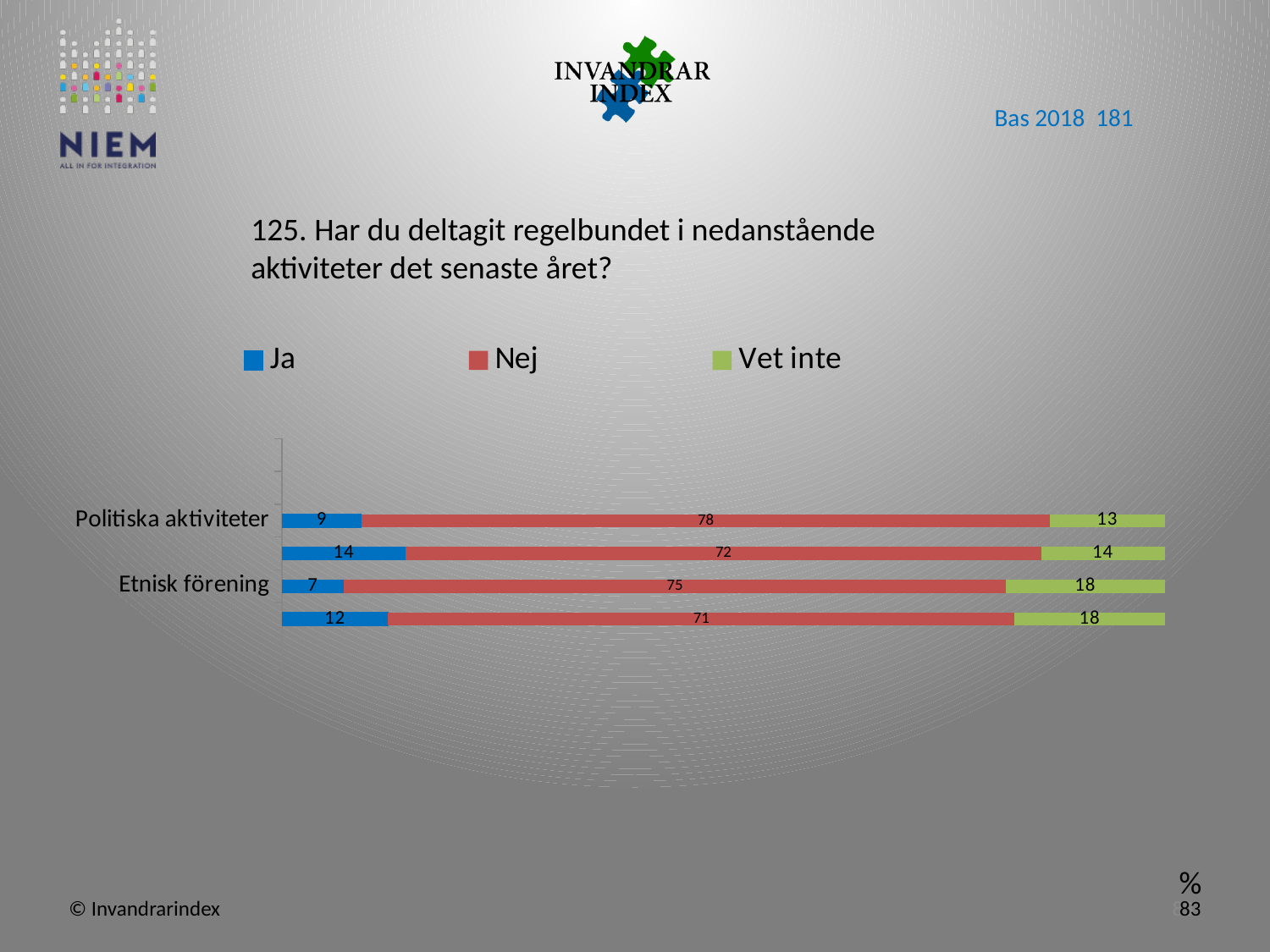
Which has the larger Ja value, Politiska aktiviteter or Etnisk förening? Politiska aktiviteter What is the difference between the Nej values for Politiska aktiviteter and Etnisk förening? 3 What is the value for Vet inte for Etnisk förening? 18 What is the value for Nej for Politiska aktiviteter? 78 What is the value for Ja for Politiska aktiviteter? 9 Which series has the highest value for Etnisk förening? Nej What are the legend entries of the chart? Ja, Nej, Vet inte What kind of chart is shown on the slide? Stacked bar chart How many series does the legend list? 3 What is the value for Ja for Etnisk förening? 7 What is the total of the stacked bar for Politiska aktiviteter? 100 What is the value for Nej for Etnisk förening? 75